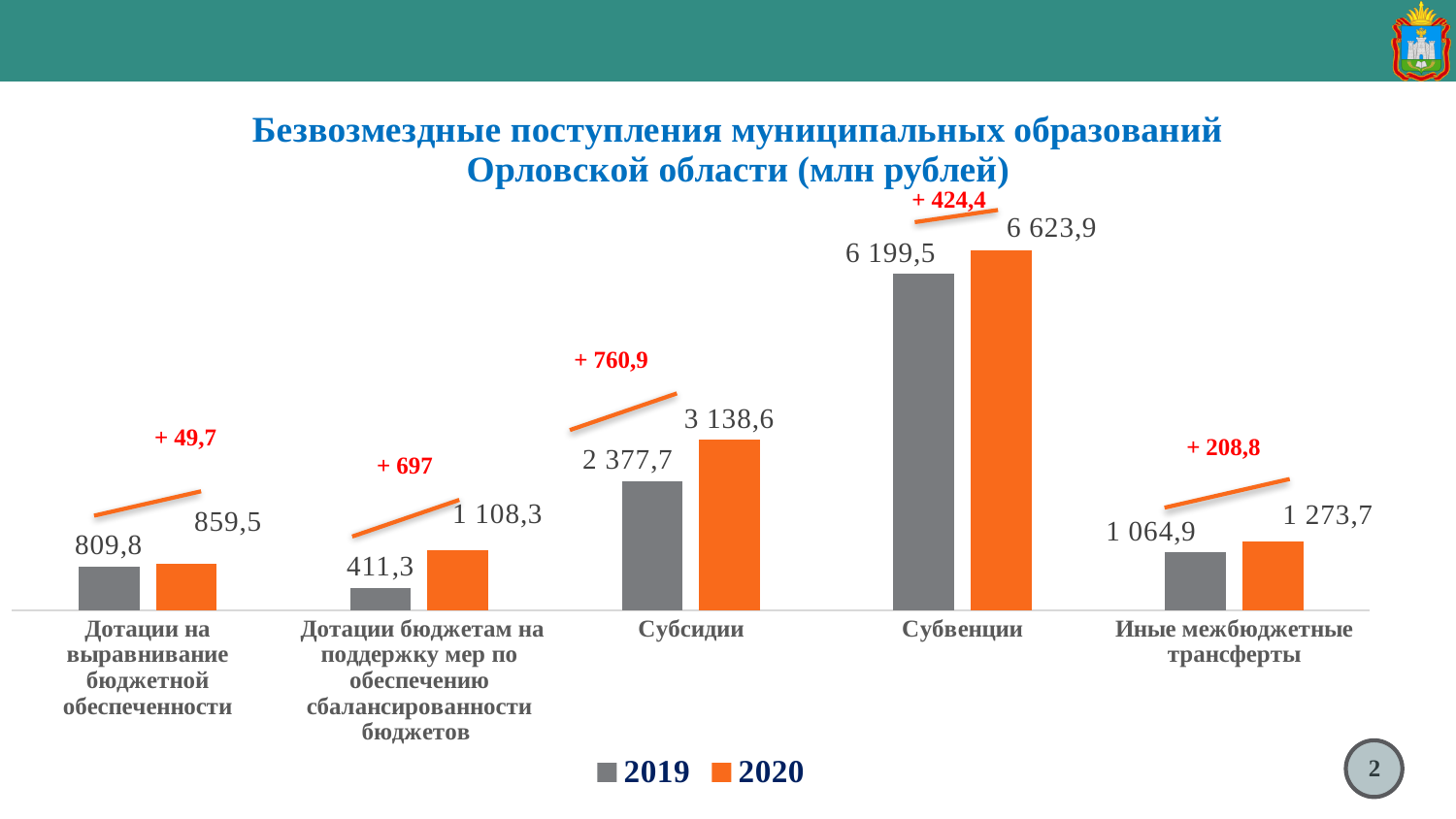
Which category has the lowest 2019 value? Дотации бюджетам на поддержку мер по обеспечению сбалансированности бюджетов How many categories are shown on the x axis? 5 What is the title of the chart? Безвозмездные поступления муниципальных образований Орловской области (млн рублей) What is the 2019 value for Субсидии? 2 377,7 Which is larger for Дотации на выравнивание бюджетной обеспеченности: the 2019 value or the 2020 value? 2020 What is the difference between the 2020 and 2019 values for Субсидии? 760,9 What is the 2019 value for Дотации бюджетам на поддержку мер по обеспечению сбалансированности бюджетов? 411,3 How many series does the legend list? 2 What is the 2020 value for Субвенции? 6 623,9 Which category has the highest 2020 value? Субвенции What is the 2020 value for Иные межбюджетные трансферты? 1 273,7 What kind of chart is shown on the slide? bar chart